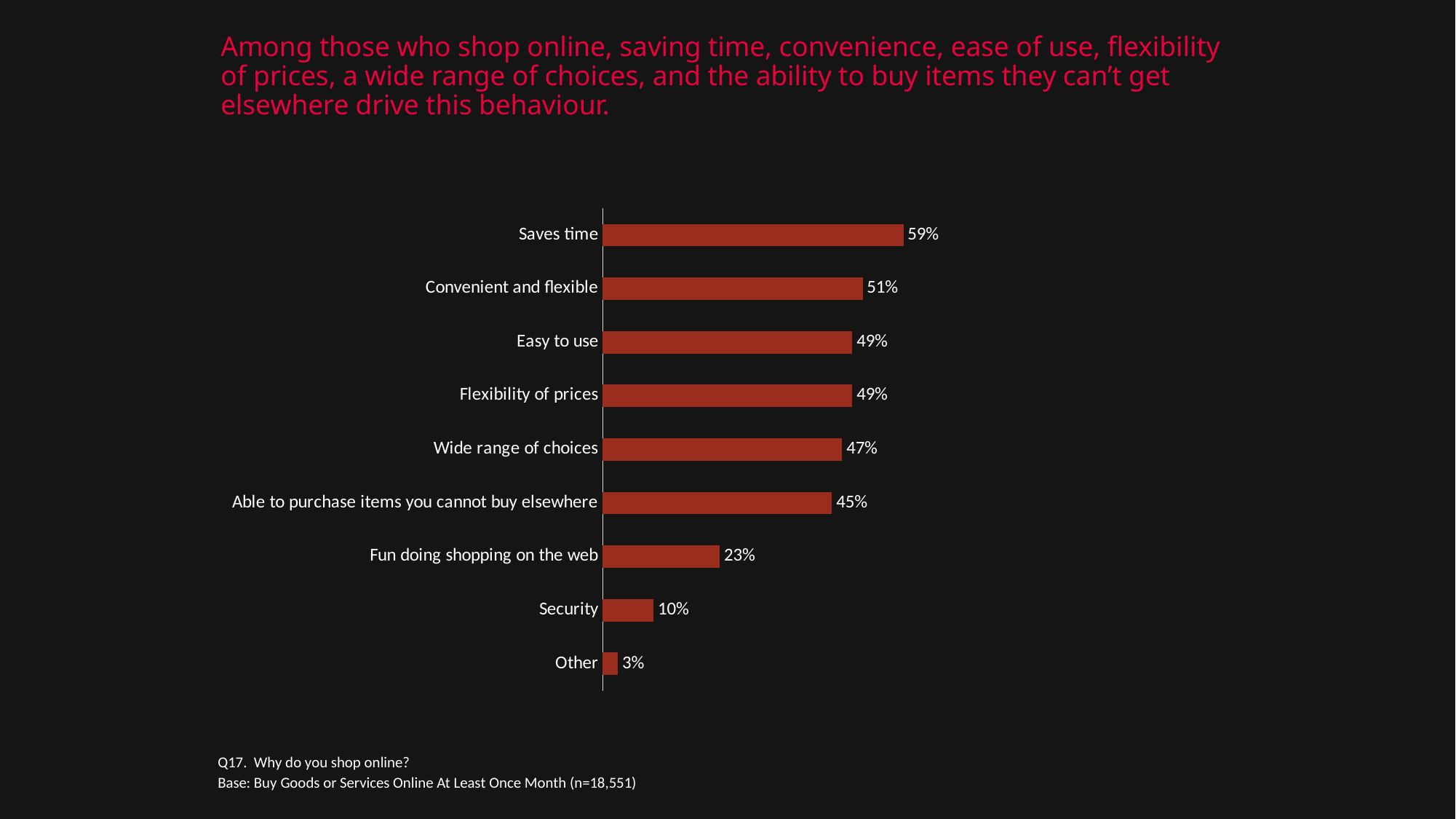
What type of chart is shown on the slide? Bar chart Which is larger: the value for "Able to purchase items you cannot buy elsewhere" or the value for "Fun doing shopping on the web"? Able to purchase items you cannot buy elsewhere What is the base sample size (n) stated at the bottom of the slide? n=18,551 How many categories (reasons) are shown in the chart? 9 Which category has the lowest percentage? Other What is the value shown for "Fun doing shopping on the web"? 23% What is the value shown for "Security"? 10% Which reason for shopping online has the highest percentage? Saves time What is the difference between the values for "Saves time" and "Convenient and flexible"? 8% What percentage of online shoppers cite "Saves time" as a reason for shopping online? 59% Which two categories share the same value of 49%? Easy to use and Flexibility of prices What is the difference between "Wide range of choices" and "Security"? 37%